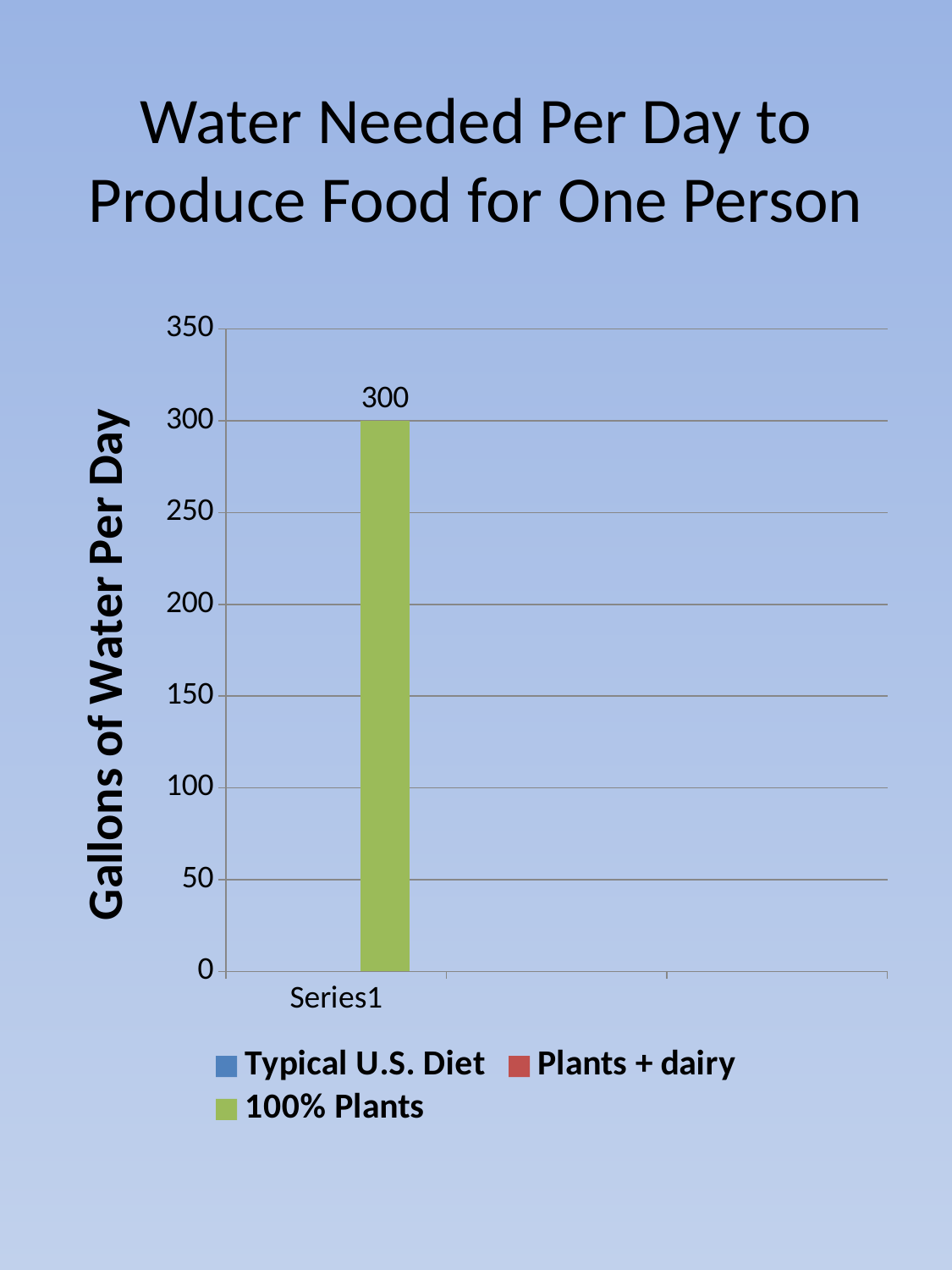
What colour is the 100% Plants series in the legend? green Is the value for 100% Plants greater or less than 250? greater What value is shown for the 100% Plants bar? 300 Is the value for 100% Plants greater or less than 350? less What is the label on the horizontal axis under the bar? Series1 What kind of chart is shown on the slide? bar chart How many bars are plotted on the chart? 1 What is the title of the vertical axis? Gallons of Water Per Day How many series does the legend list? 3 What is the highest tick value shown on the vertical axis? 350